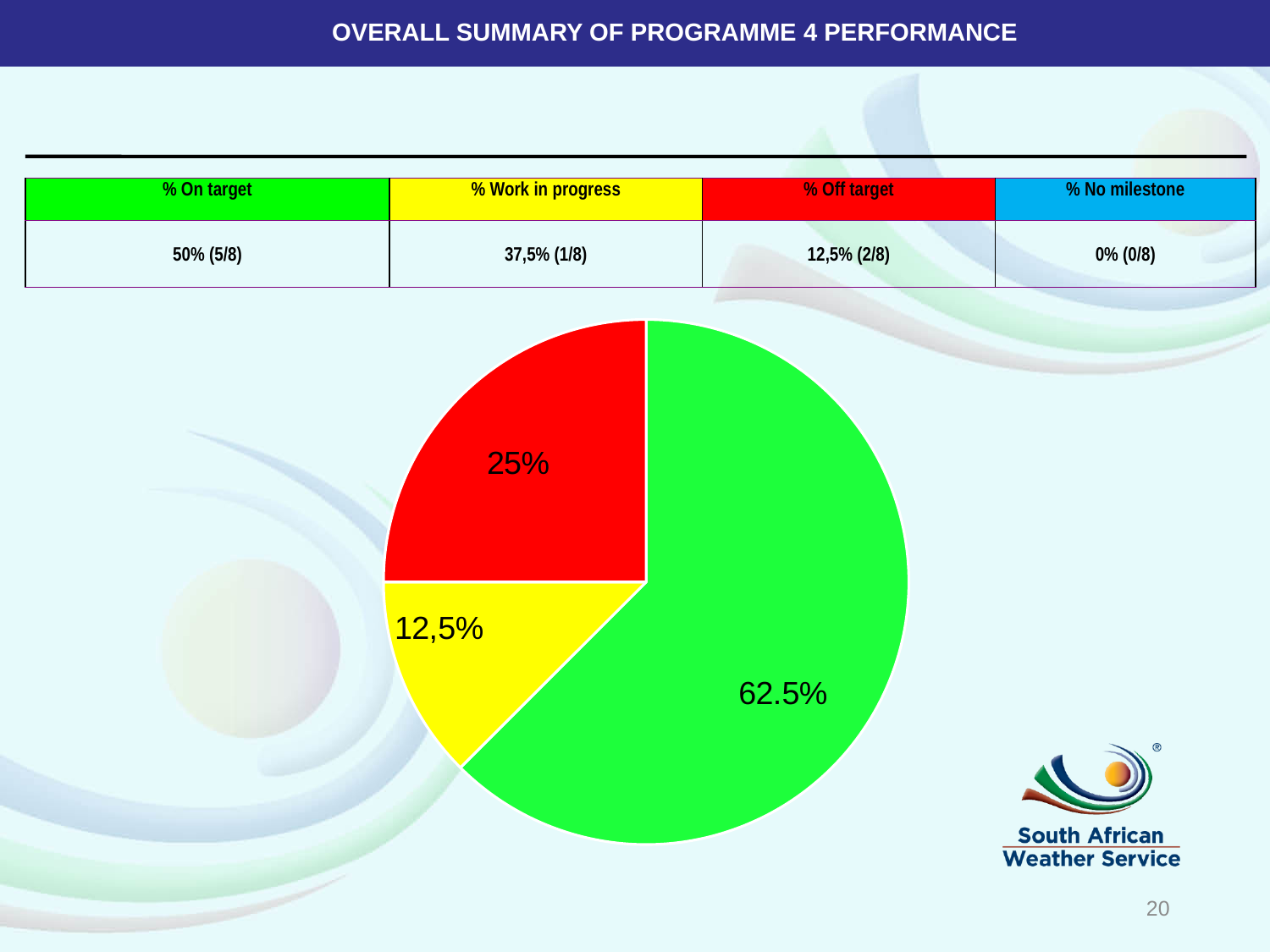
What percentage is shown on the yellow slice of the pie chart? 12,5% What colour is the largest slice of the pie chart? Green Which is larger in the pie chart, the red slice or the yellow slice? The red slice Is the green slice of the pie chart greater or less than 50% of the pie? greater What percentage is shown on the green slice of the pie chart? 62.5% What percentage is shown on the red slice of the pie chart? 25% What kind of chart is shown on the slide? Pie chart Which slice of the pie chart is the smallest? The yellow slice (12,5%) How many slices does the pie chart have? 3 What is the combined share of the red and yellow slices in the pie chart? 37.5% Which slice of the pie chart is the largest? The green slice (62.5%) What is the difference between the green slice and the red slice in the pie chart? 37.5%